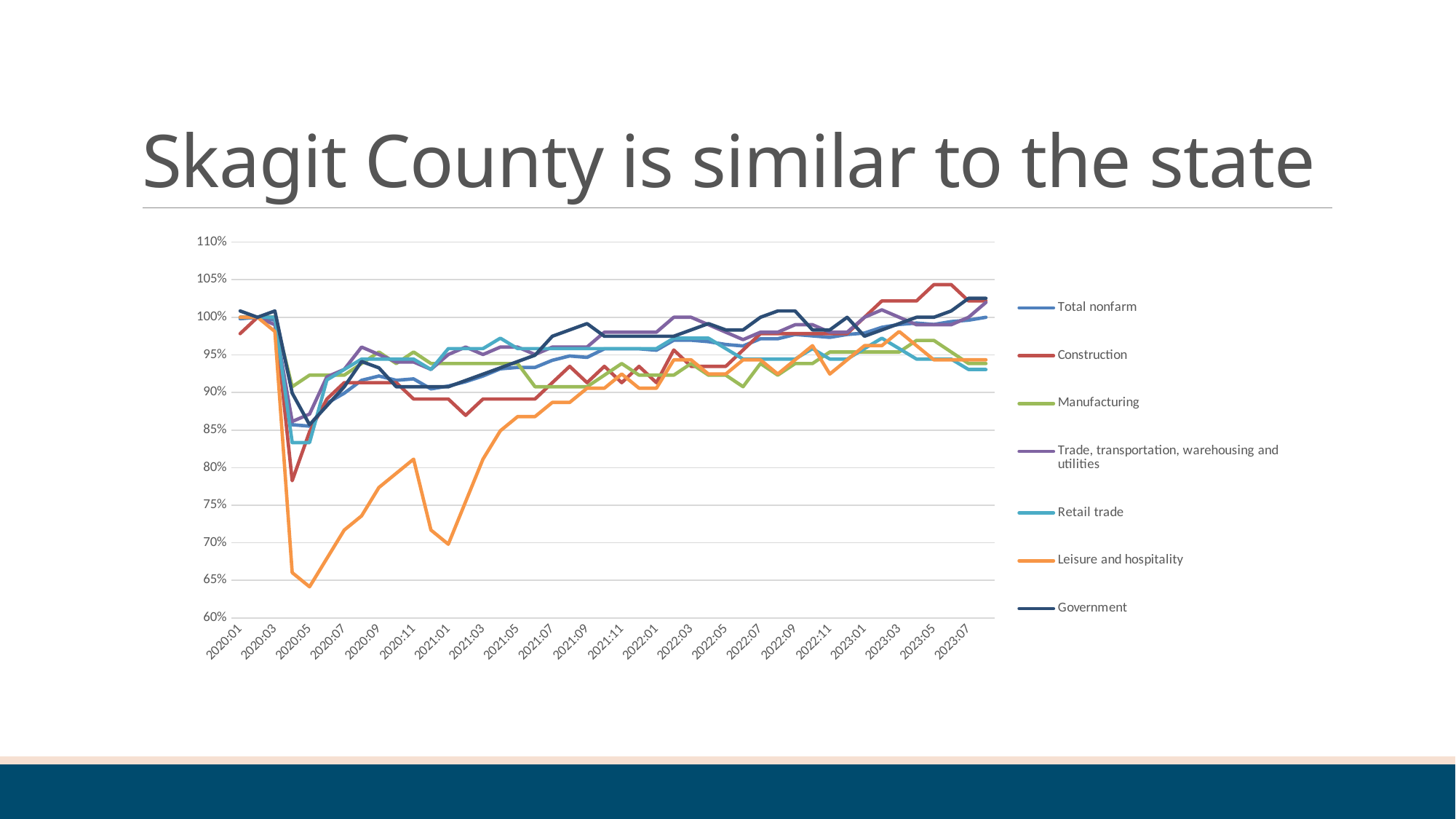
How many series does the legend list? 7 Is the value for Leisure and hospitality at 2021:01 greater or less than 75%? less Is the value for Manufacturing at 2020:05 greater or less than 85%? greater Is the value for Leisure and hospitality at 2020:05 greater or less than 70%? less What is the title of the slide? Skagit County is similar to the state At 2020:05, which is lower: Leisure and hospitality or Construction? Leisure and hospitality Which series drops to the lowest value around 2020:05? Leisure and hospitality What is the first label on the x axis? 2020:01 What kind of chart is shown on the slide? Line chart Does the Leisure and hospitality line rise or fall from 2020:05 to 2023:07? Rise